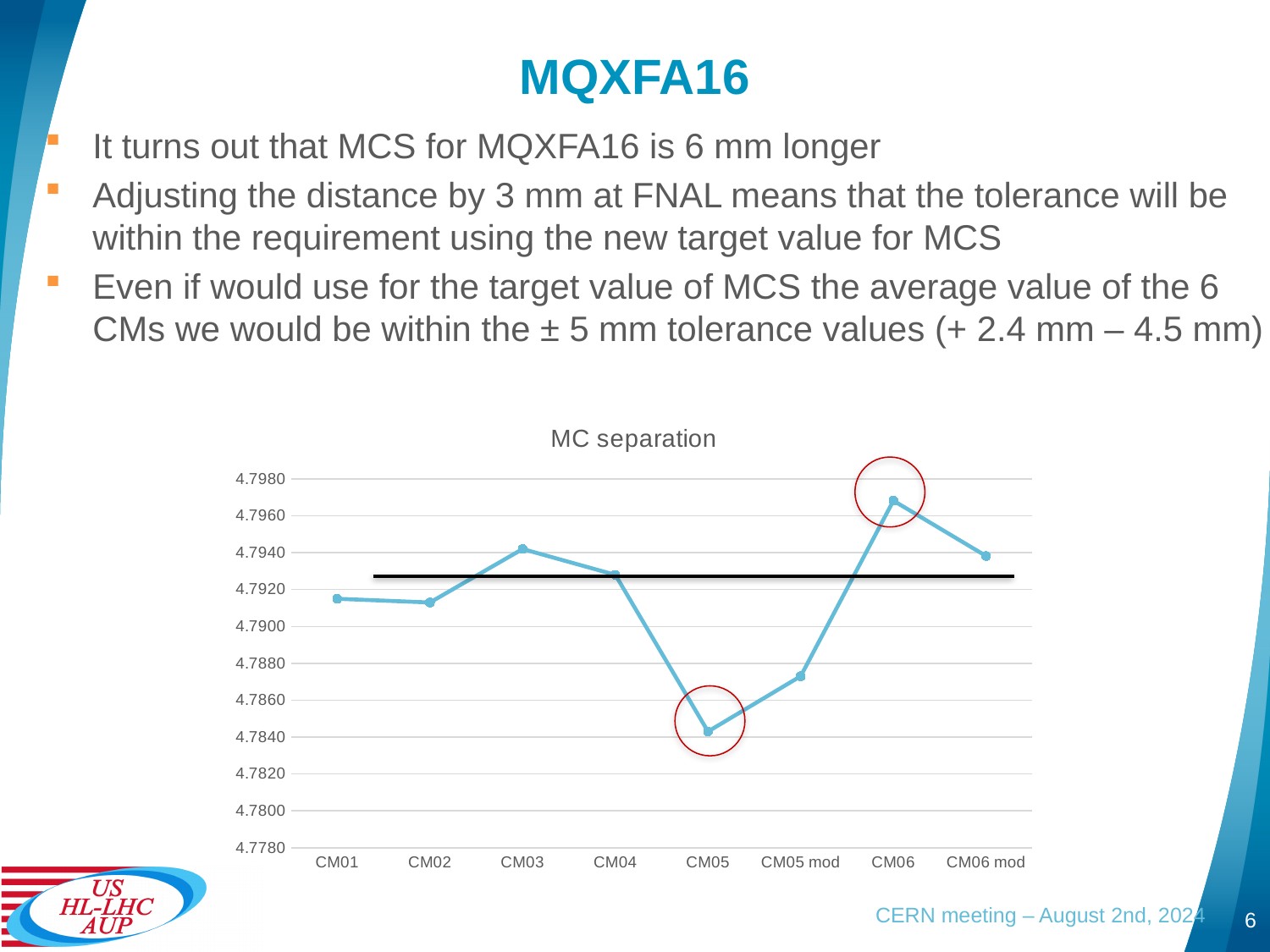
What type of chart is shown on the slide? line chart Which category has the lowest value in the MC separation chart? CM05 Is the value for CM01 greater or less than 4.7900? greater Does the line rise or fall from CM04 to CM05? fall How many categories are plotted along the x axis of the chart? 8 Which is larger, the value for CM06 or the value for CM06 mod? CM06 Is the value for CM05 mod greater or less than 4.7880? less What is the title of the chart? MC separation Is the value for CM06 greater or less than 4.7960? greater Which is larger, the value for CM05 or the value for CM05 mod? CM05 mod Which category has the highest value in the MC separation chart? CM06